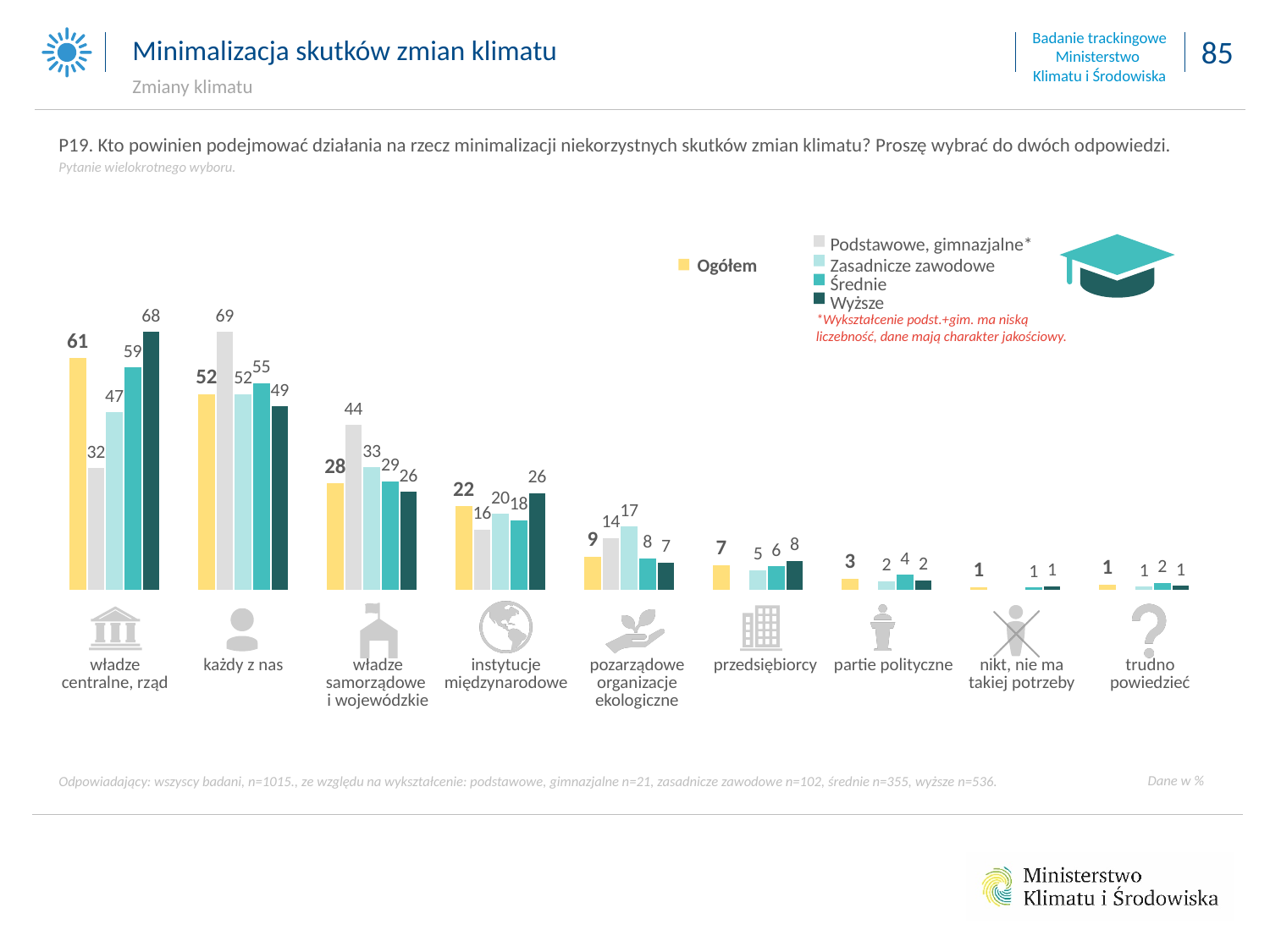
Which category has the lowest Podstawowe, gimnazjalne value among those with a labelled bar? pozarządowe organizacje ekologiczne What is the difference between the Wyższe and Podstawowe, gimnazjalne values for 'władze centralne, rząd'? 36 Which category has the highest Ogółem value? władze centralne, rząd Which is larger for 'instytucje międzynarodowe': the Wyższe value or the Ogółem value? Wyższe How many series does the legend list in total, including Ogółem? 5 Which colour represents the Ogółem series? yellow What kind of chart is shown on the slide? bar chart How many categories are shown on the x axis? 9 What is the Podstawowe, gimnazjalne value for 'władze samorządowe i wojewódzkie'? 44 Do the Ogółem values rise or fall from left to right across the categories? fall What is the Wyższe value for 'każdy z nas'? 49 What is the Ogółem value for 'władze centralne, rząd'? 61